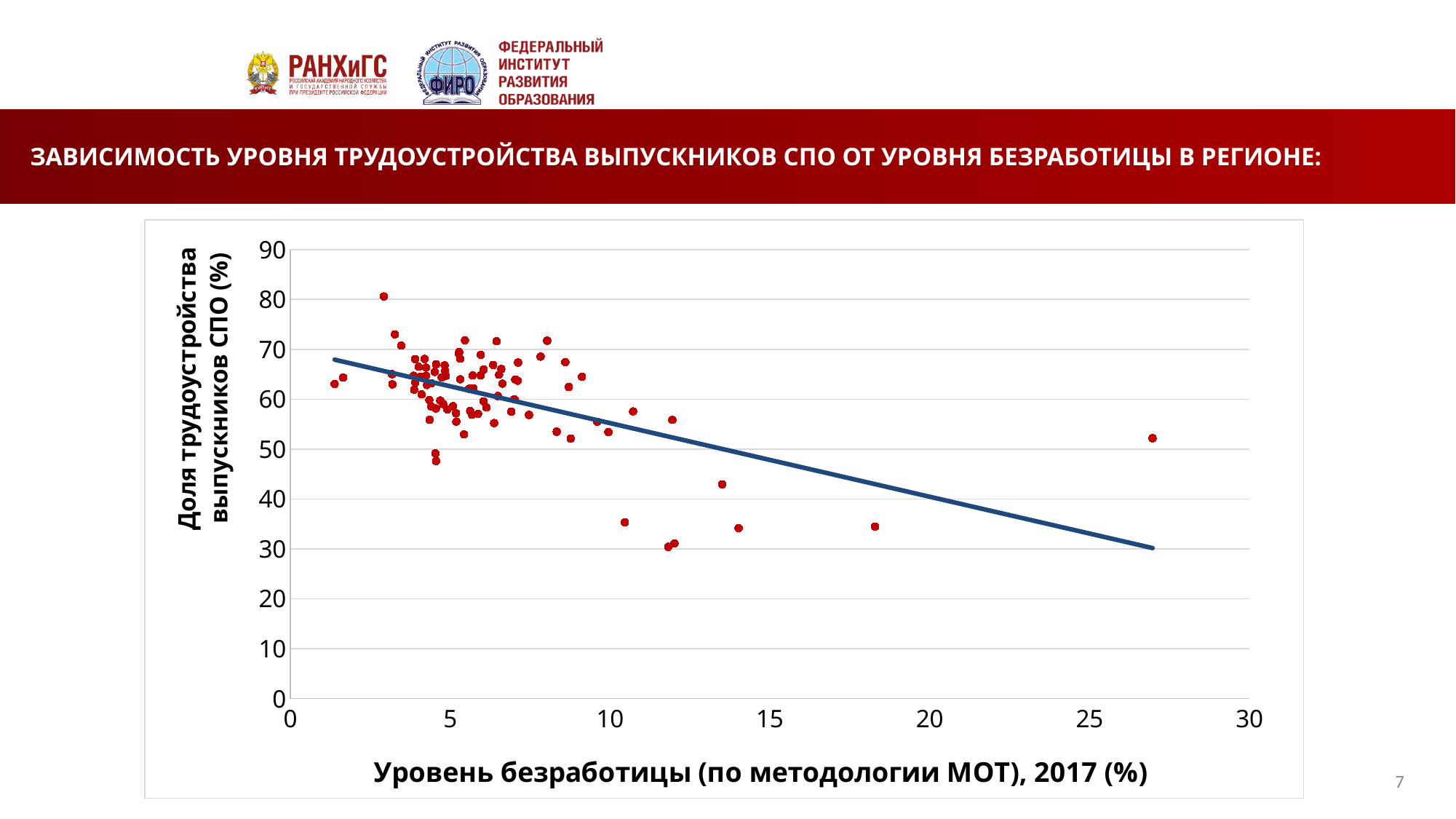
Is the trend line's value at an unemployment rate of 25% greater or less than 40? less Is the trend line's value at an unemployment rate of 5% greater or less than 60? greater What is the maximum value shown on the x axis of the chart? 30 Is the highest plotted point on the chart greater or less than 70 on the y axis? greater What is the label of the y axis of the chart? Доля трудоустройства выпускников СПО (%) What is the label of the x axis of the chart? Уровень безработицы (по методологии МОТ), 2017 (%) As the unemployment rate on the x axis increases, does the trend line for the share of employed SPO graduates rise or fall? fall What kind of chart is shown on the slide? scatter chart Which is larger: the y value of the highest point near an unemployment rate of 3%, or the y value of the point at an unemployment rate of about 18%? the point near 3%